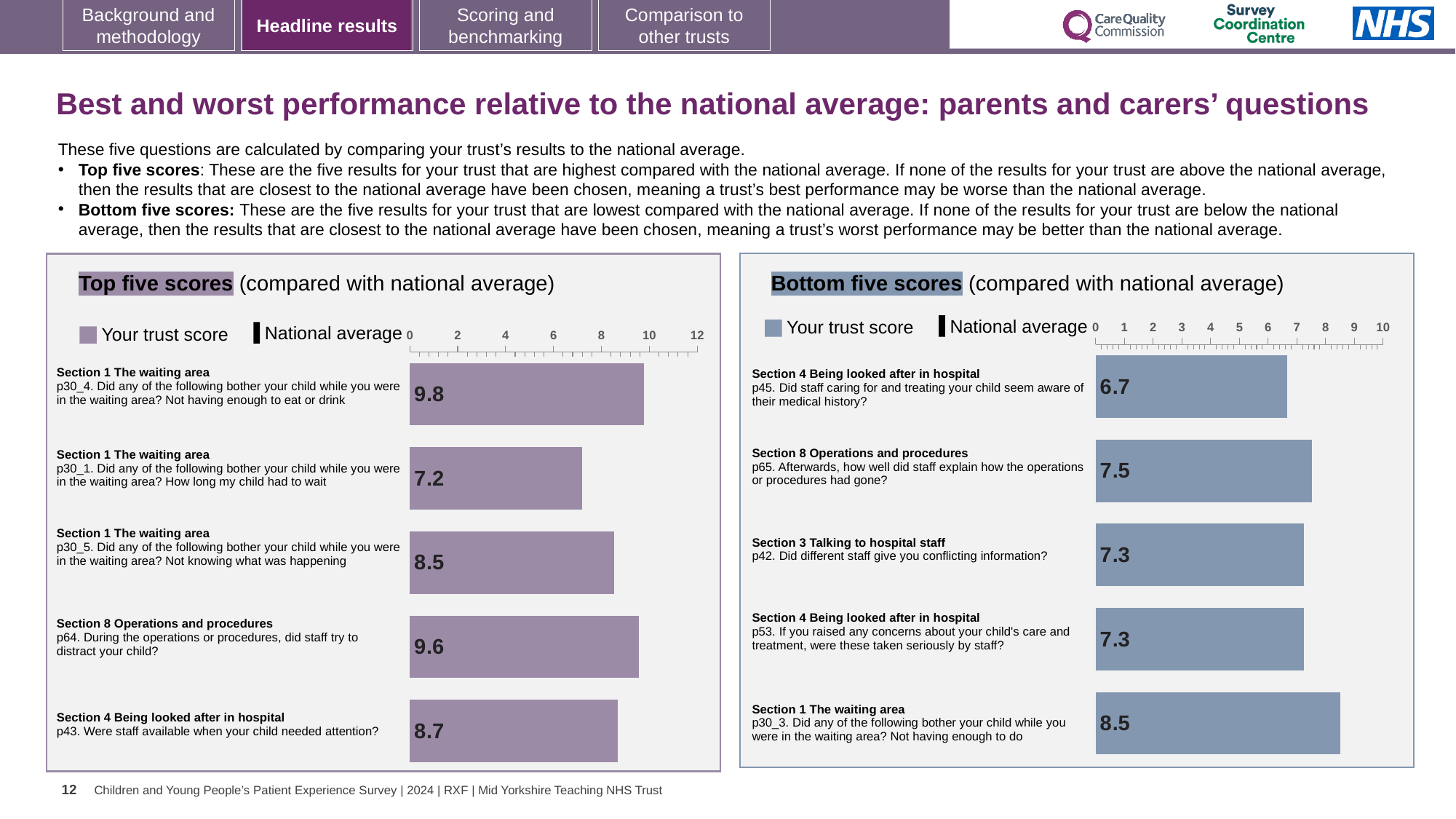
How many questions are plotted in the Top five scores chart? 5 In the Bottom five scores chart, which has the larger trust score: p65 or p42? p65 In the Top five scores chart, what is the trust score for p64 (did staff try to distract your child during operations or procedures)? 9.6 In the Top five scores chart, what is the trust score for p30_4 (Not having enough to eat or drink in the waiting area)? 9.8 In the Bottom five scores chart, what is the difference between the trust scores for p30_3 and p45? 1.8 In the Top five scores chart, which question has the lowest trust score? p30_1. How long my child had to wait In the Bottom five scores chart, what is the trust score for p45 (staff aware of your child's medical history)? 6.7 In the Bottom five scores chart, which question has the highest trust score? p30_3. Not having enough to do In the Bottom five scores chart, what is the trust score for p30_3 (Not having enough to do in the waiting area)? 8.5 What kind of chart is the Bottom five scores chart? Bar chart How many entries does the legend of the Top five scores chart list? 2 In the Top five scores chart, what is the difference between the trust scores for p30_4 and p30_1? 2.6